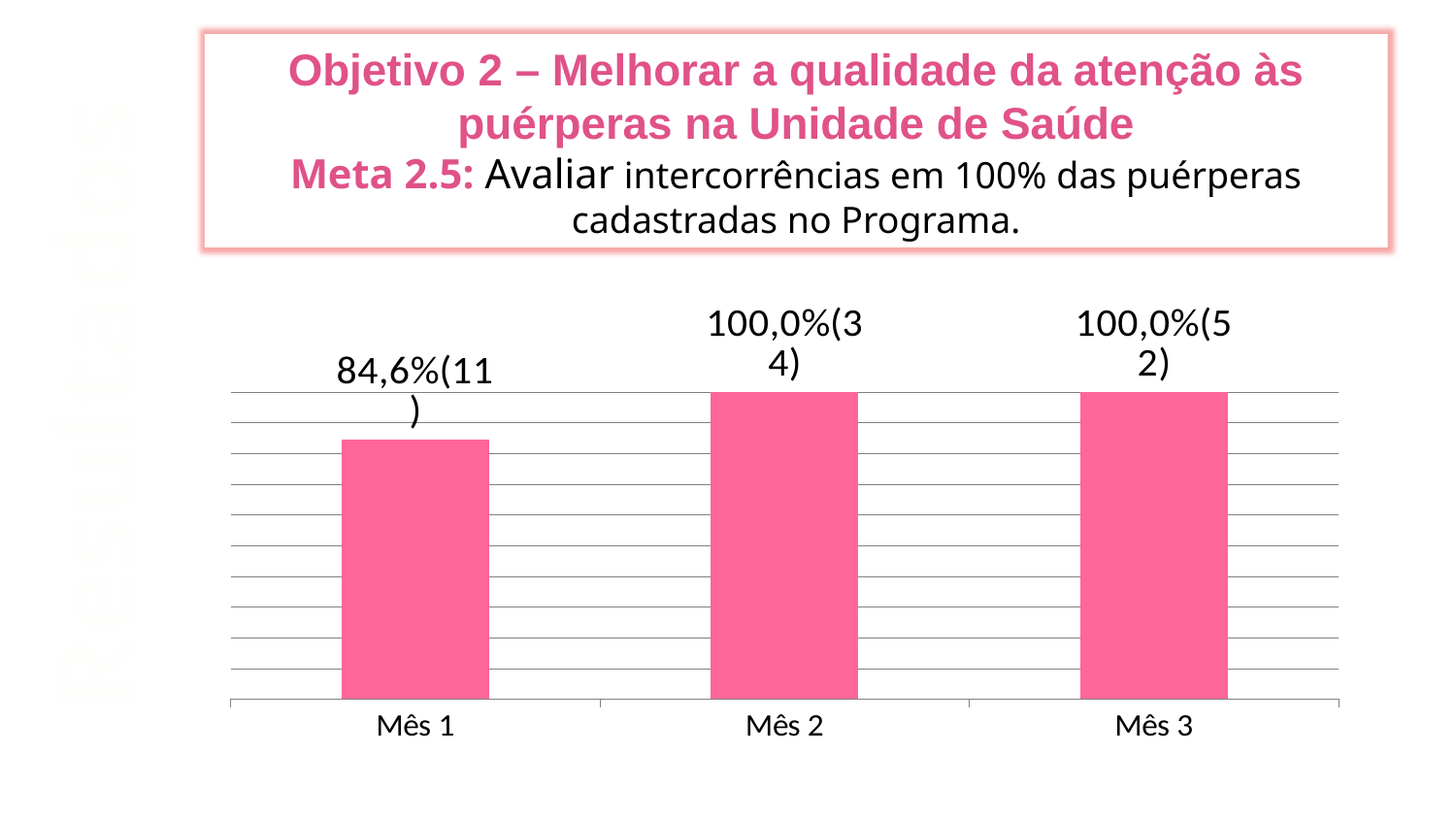
Which month has the lowest percentage? Mês 1 What percentage is shown for Mês 1? 84,6% What is the difference in percentage points between Mês 2 and Mês 1? 15,4 What is the number in parentheses shown for Mês 3? 52 What kind of chart is shown on the slide? Bar chart Do the percentages rise or fall from Mês 1 to Mês 2? Rise What is the data label shown for Mês 1? 84,6%(11) What is the data label shown for Mês 3? 100,0%(52) What colour are the bars in the chart? Pink Which is larger, the percentage for Mês 1 or for Mês 2? Mês 2 How many months (categories) are shown on the x axis? 3 What is the data label shown for Mês 2? 100,0%(34)